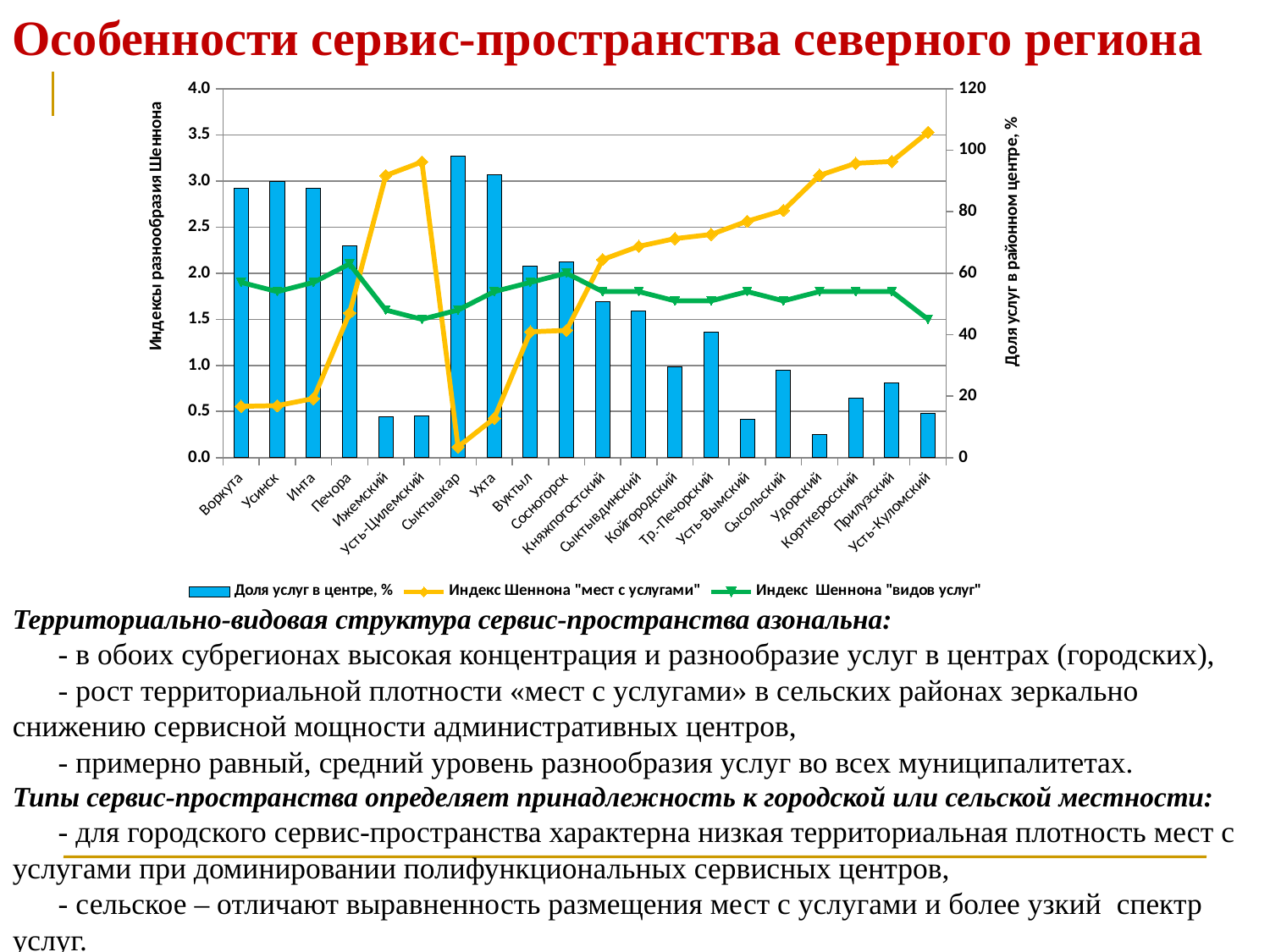
Which category has the highest value on the line "Индекс Шеннона "мест с услугами""? Усть-Куломский How many series does the legend list? 3 Which has the taller bar for "Доля услуг в центре, %": Ухта or Вуктыл? Ухта Which category has the lowest value on the line "Индекс Шеннона "мест с услугами""? Сыктывкар Which has the taller bar for "Доля услуг в центре, %": Воркута or Печора? Воркута Which category has the shortest bar for "Доля услуг в центре, %"? Удорский Which category has the tallest bar for "Доля услуг в центре, %"? Сыктывкар Does the line "Индекс Шеннона "мест с услугами"" rise or fall from Княжпогостский to Усть-Куломский? rise How many categories are shown on the x axis? 20 What is the title of the left vertical axis? Индексы разнообразия Шеннона What kind of chart is used for the series "Доля услуг в центре, %"? bar chart What is the title of the right vertical axis? Доля услуг в районном центре, %